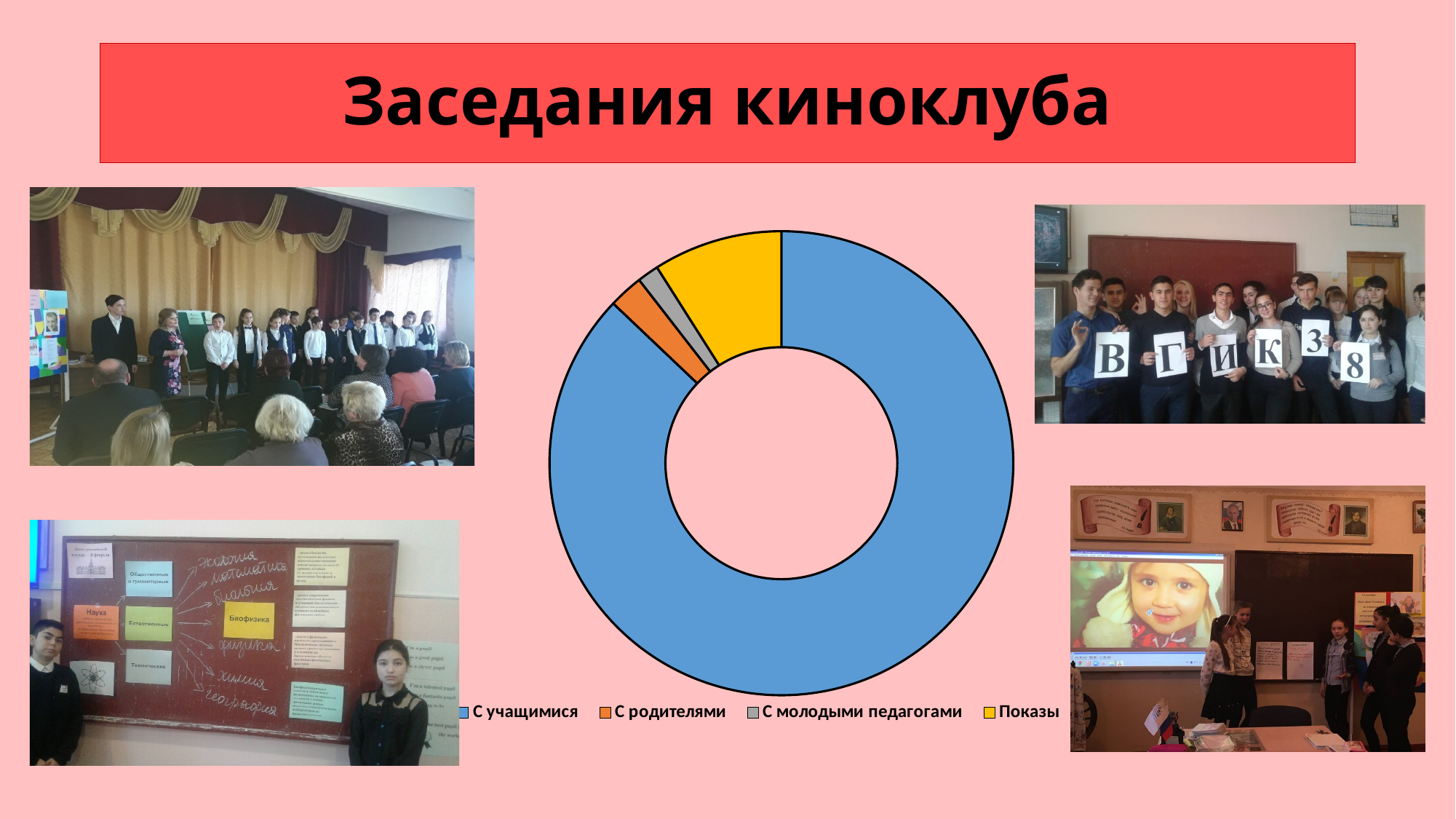
Which has the larger share of the chart, С учащимися or Показы? С учащимися Which has the larger share of the chart, С родителями or С молодыми педагогами? С родителями Which category is shown in blue on the chart? С учащимися Which category has the smallest share of the doughnut chart? С молодыми педагогами What kind of chart is shown on the slide? doughnut chart Which has the larger share of the chart, Показы or С родителями? Показы Which category is shown in yellow on the chart? Показы Which category has the largest share of the doughnut chart? С учащимися How many categories does the chart's legend list? 4 Does the share for С учащимися cover more or less than half of the doughnut chart? more